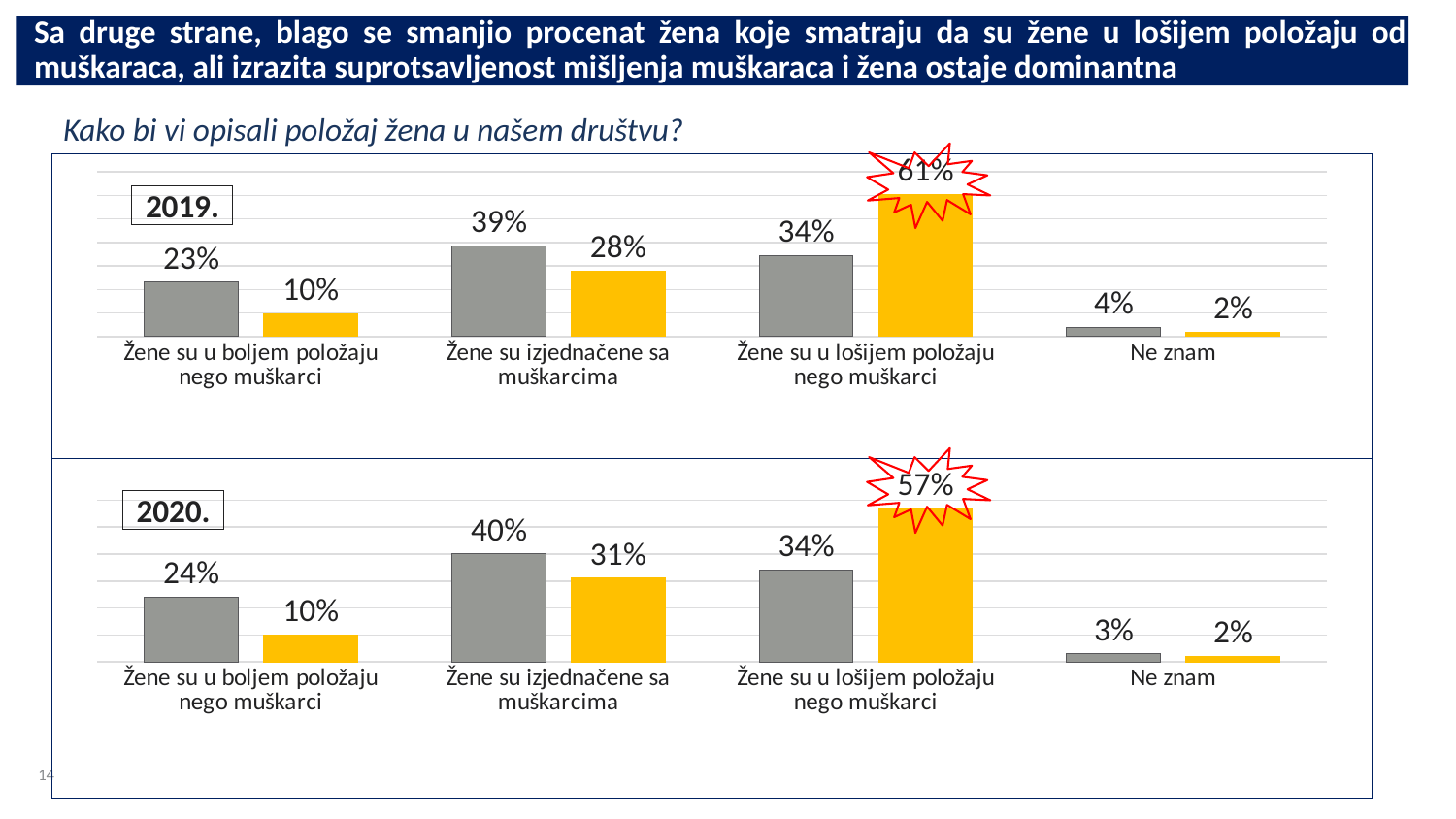
In the 2019 chart, what is the difference between the yellow and gray bars for "Žene su u lošijem položaju nego muškarci"? 27% In the 2020 chart, which category has the lowest gray bar? Ne znam In the 2019 chart, what is the value of the yellow bar for "Žene su u lošijem položaju nego muškarci"? 61% What question is shown as the heading above the charts? Kako bi vi opisali položaj žena u našem društvu? In the 2019 chart, which category has the highest yellow bar? Žene su u lošijem položaju nego muškarci In the 2019 chart, what is the value of the gray bar for "Žene su izjednačene sa muškarcima"? 39% How many categories are shown on the x axis of the 2019 chart? 4 In the 2020 chart, what is the value of the yellow bar for "Žene su u lošijem položaju nego muškarci"? 57% In the 2020 chart, which is larger for "Žene su u boljem položaju nego muškarci": the gray bar or the yellow bar? the gray bar In the 2020 chart, what is the difference between the gray and yellow bars for "Žene su izjednačene sa muškarcima"? 9% What type of chart is the 2020 chart? bar chart In the 2020 chart, what is the value of the gray bar for "Žene su u boljem položaju nego muškarci"? 24%